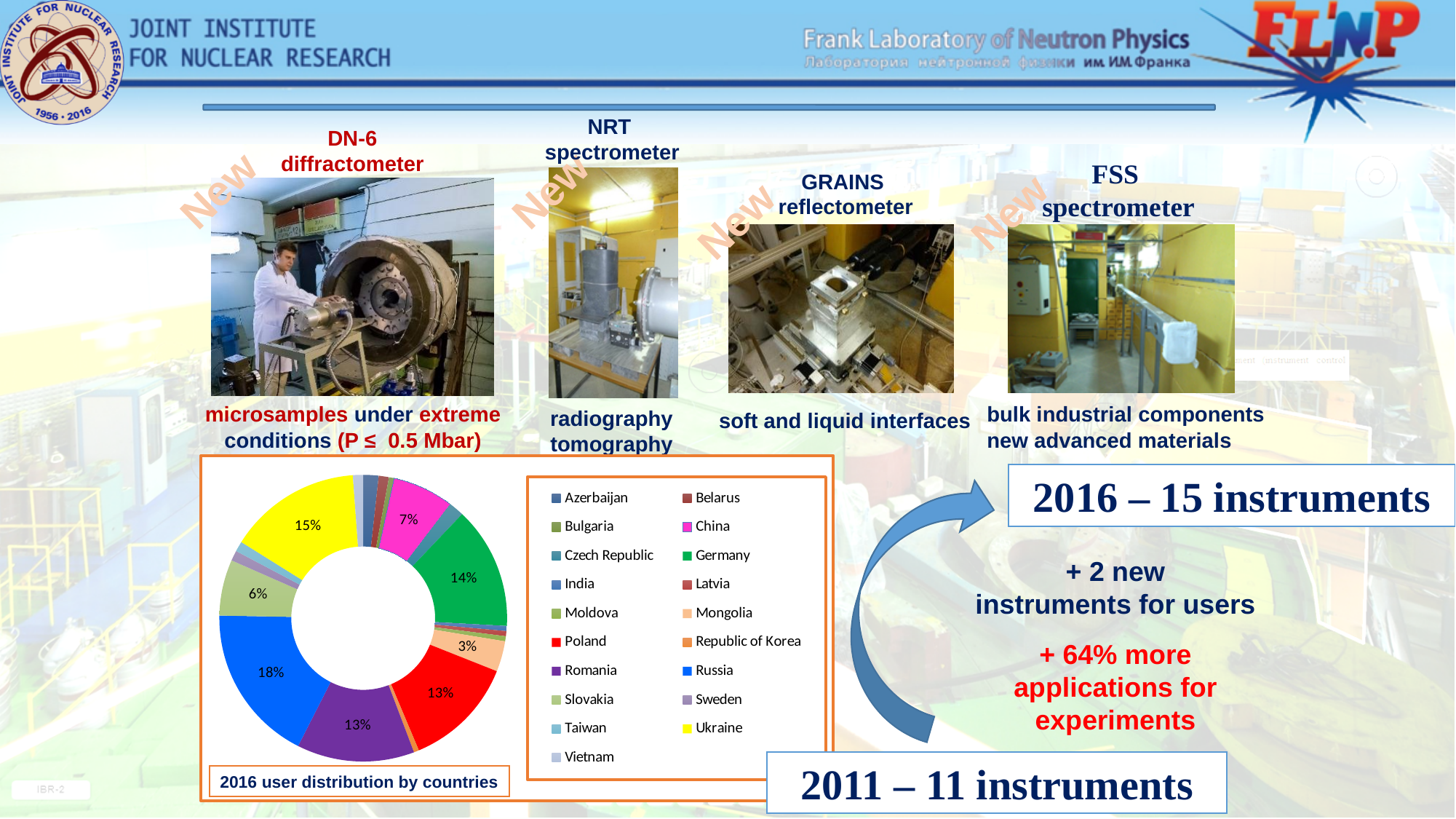
What is the difference between the shares of Russia and Ukraine in the 2016 user distribution chart? 3% What is the title of the chart on the slide? 2016 user distribution by countries What share of users does China have in the 2016 user distribution chart? 7% How many countries are listed in the legend of the 2016 user distribution chart? 19 Which has a larger share in the 2016 user distribution chart, Germany or Slovakia? Germany What share of users does Ukraine have in the 2016 user distribution chart? 15% What share of users does Russia have in the 2016 user distribution chart? 18% What share of users does Mongolia have in the 2016 user distribution chart? 3% Which country has the largest share in the 2016 user distribution chart? Russia What share of users does Germany have in the 2016 user distribution chart? 14% What is the combined share of Poland and Romania in the 2016 user distribution chart? 26% What type of chart is shown on the slide? Doughnut (pie) chart